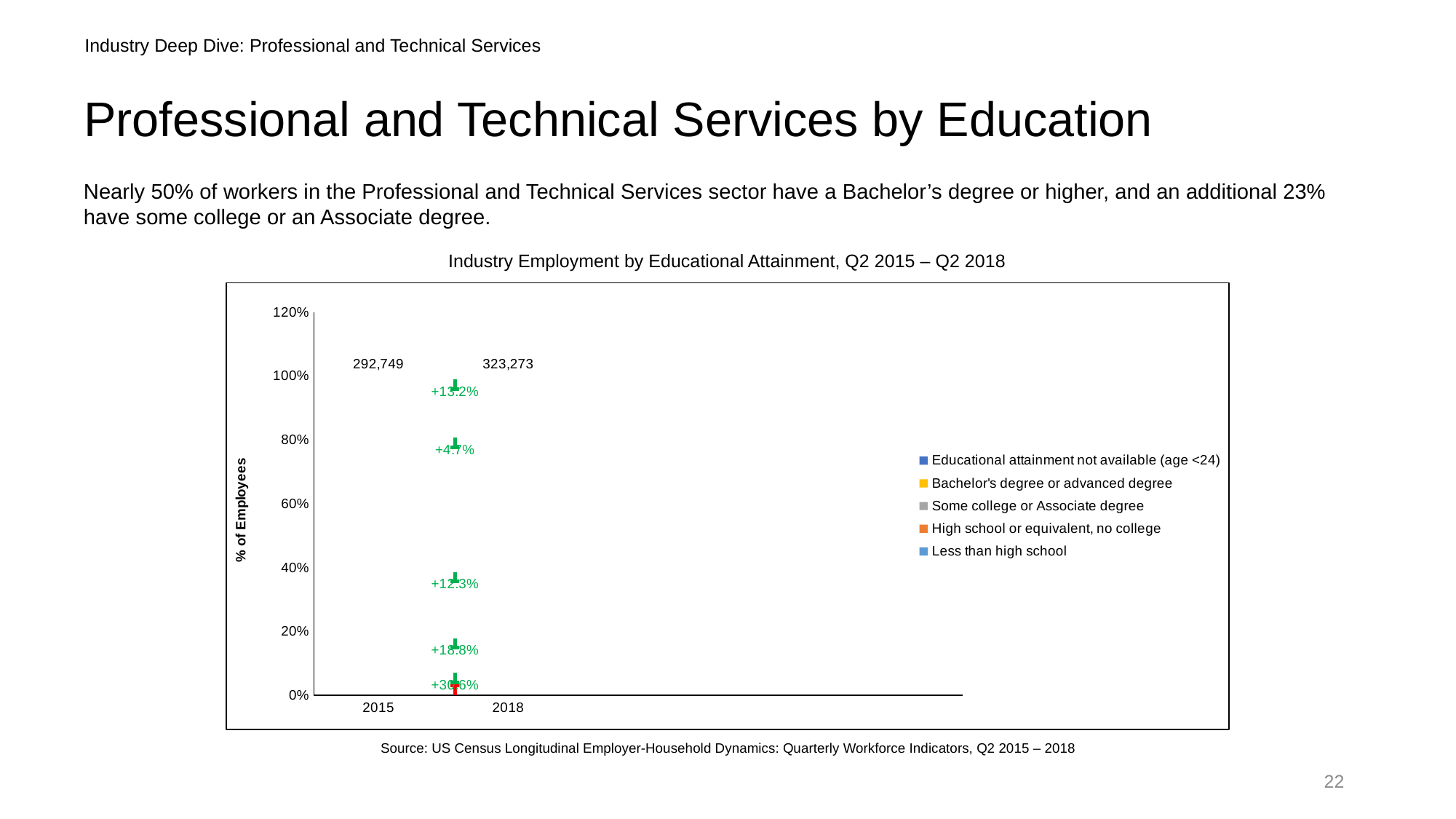
What is the title of the chart? Industry Employment by Educational Attainment, Q2 2015 – Q2 2018 Does total employment rise or fall from 2015 to 2018? rise Which year has the higher total employment figure, 2015 or 2018? 2018 How many percentage change labels are shown between the 2015 and 2018 bars? 5 What total employment figure is printed above the 2018 bar? 323,273 What is the label on the y axis of the chart? % of Employees What total employment figure is printed above the 2015 bar? 292,749 How many series does the chart legend list? 5 What is the largest percentage change label shown between the 2015 and 2018 bars? +30.6% What is the smallest percentage change label shown between the 2015 and 2018 bars? +4.7% How many years are shown on the x axis of the chart? 2 What is the difference between the 2018 and 2015 total employment figures? 30,524